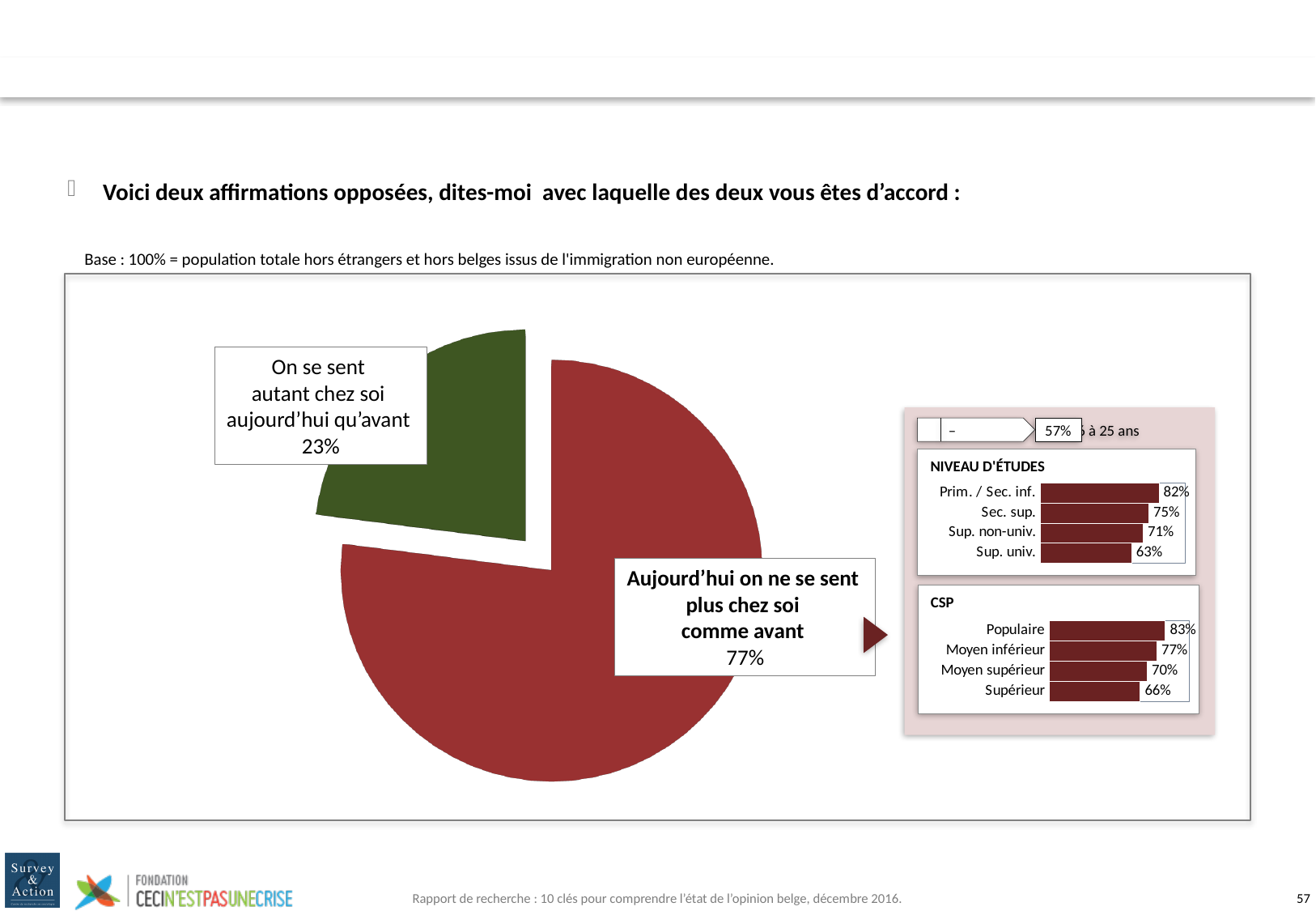
In the NIVEAU D'ÉTUDES bar chart, which category has the highest value? Prim. / Sec. inf. In the CSP bar chart, which category has the lowest value? Supérieur How many slices does the pie chart have? 2 In the NIVEAU D'ÉTUDES bar chart, what is the difference between Prim. / Sec. inf. and Sup. univ.? 19% In the NIVEAU D'ÉTUDES bar chart, what is the value for Sup. univ.? 63% How many categories are shown in the CSP bar chart? 4 In the pie chart, what share of respondents agree with "On se sent autant chez soi aujourd'hui qu'avant"? 23% In the CSP bar chart, what is the value for Moyen inférieur? 77% What type of chart is the large chart on the left of the slide? pie chart In the pie chart, which statement has the larger share: "On se sent autant chez soi aujourd'hui qu'avant" or "Aujourd'hui on ne se sent plus chez soi comme avant"? Aujourd'hui on ne se sent plus chez soi comme avant In the CSP bar chart, what is the difference between Populaire and Moyen supérieur? 13% In the pie chart, what share of respondents agree with "Aujourd'hui on ne se sent plus chez soi comme avant"? 77%